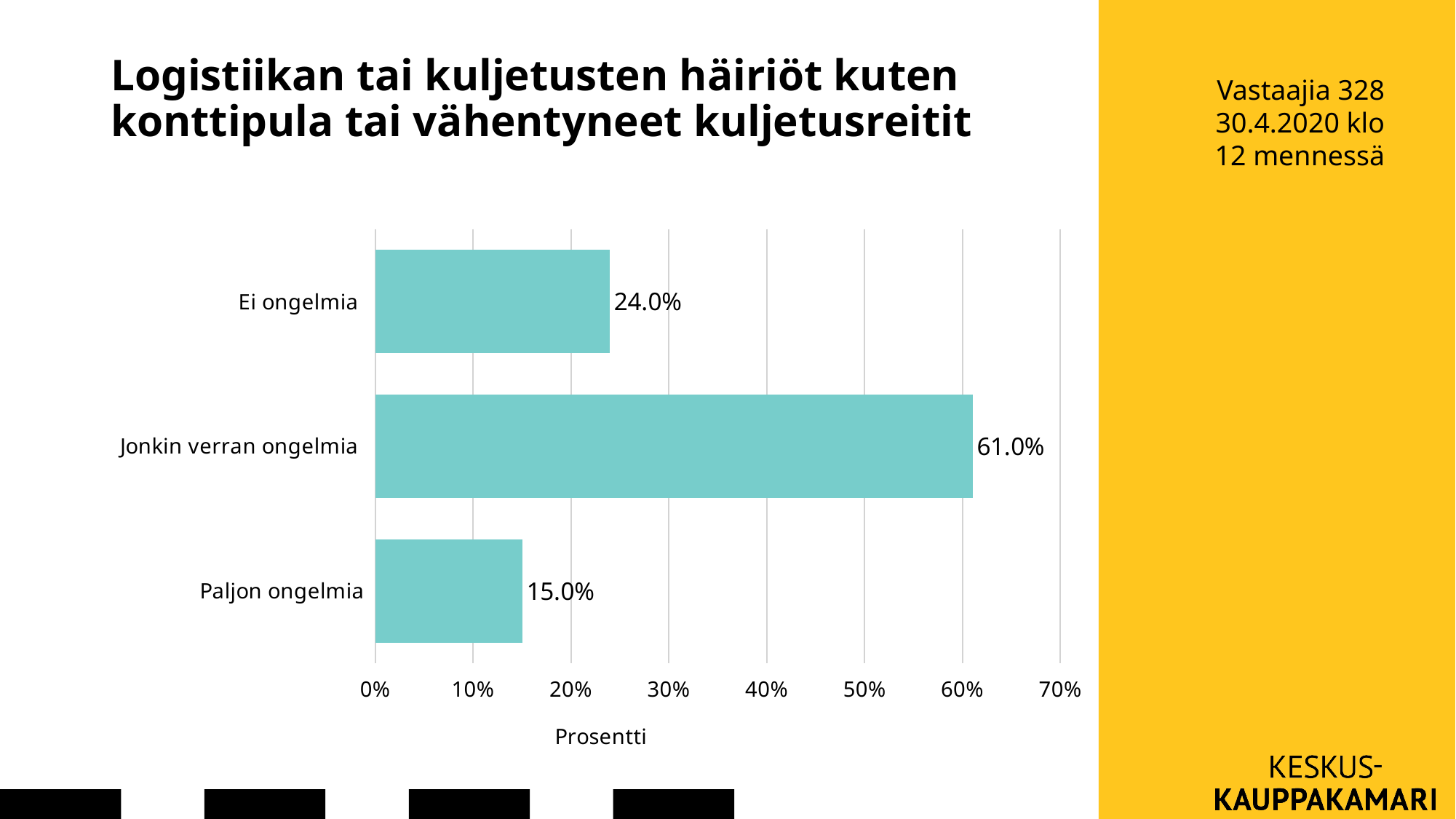
Is the value for "Jonkin verran ongelmia" greater or less than 50%? greater Which is larger, the value for "Ei ongelmia" or the value for "Paljon ongelmia"? Ei ongelmia What is the difference between the values for "Ei ongelmia" and "Paljon ongelmia"? 9.0% How many categories are shown in the chart? 3 What is the value for "Ei ongelmia"? 24.0% What is the value for "Paljon ongelmia"? 15.0% Which category has the highest value? Jonkin verran ongelmia What is the value for "Jonkin verran ongelmia"? 61.0% Which category has the lowest value? Paljon ongelmia What kind of chart is shown on the slide? Bar chart What is the label of the horizontal axis? Prosentti What is the difference between the values for "Jonkin verran ongelmia" and "Ei ongelmia"? 37.0%